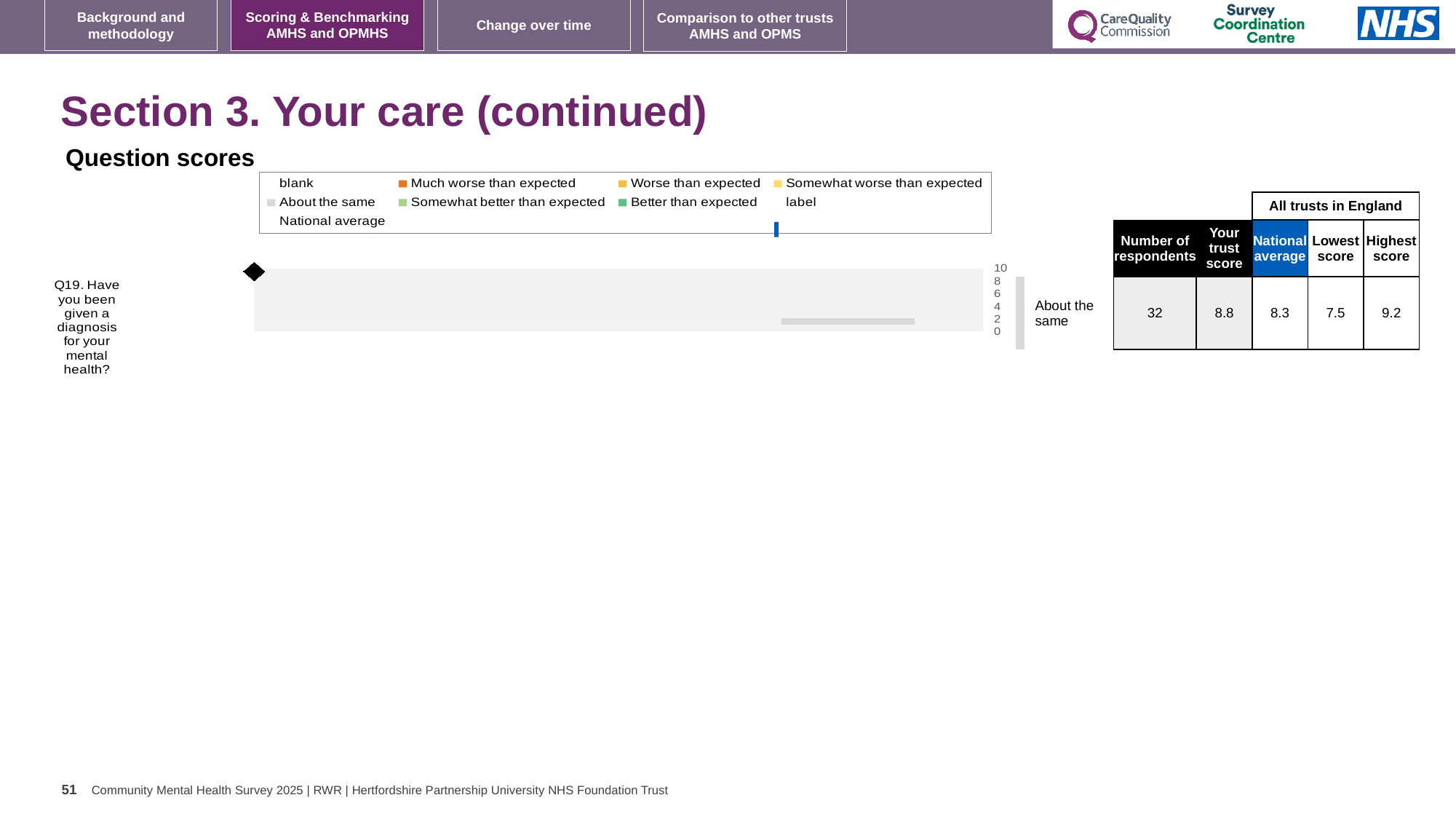
What is the highest score among all trusts in England for Q19? 9.2 What is the difference between the trust score and the national average for Q19? 0.5 What kind of chart is used to show the question scores? Bar chart Which is larger for Q19, the trust score or the national average? Trust score What benchmark category is Q19 assigned on the chart? About the same What is the difference between the highest and lowest scores for Q19 across all trusts in England? 1.7 What is the lowest score among all trusts in England for Q19? 7.5 How many respondents answered Q19? 32 What is the trust score shown for Q19 (Have you been given a diagnosis for your mental health?)? 8.8 What is the maximum value shown on the chart's score axis? 10 How many questions are plotted on the chart? 1 What is the national average score shown for Q19? 8.3